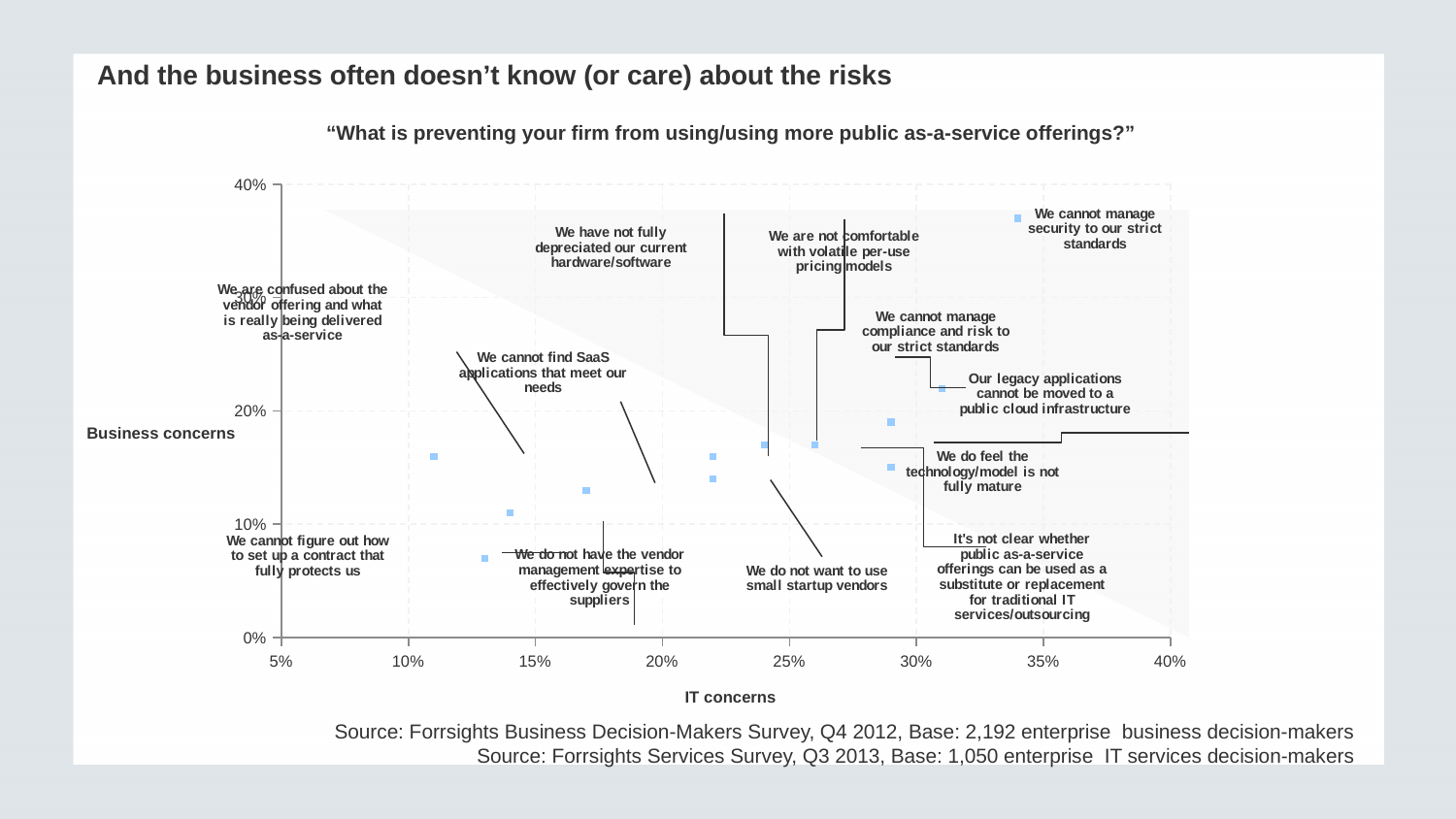
Is the Business concerns value for "We cannot manage security to our strict standards" greater or less than 30%? greater Which has the higher Business concerns value: "We cannot manage security to our strict standards" or "Our legacy applications cannot be moved to a public cloud infrastructure"? We cannot manage security to our strict standards What is the title of the horizontal axis of the chart? IT concerns Which concern has the highest Business concerns value on the chart? We cannot manage security to our strict standards What is the title of the vertical axis of the chart? Business concerns Is the IT concerns value for "We cannot manage security to our strict standards" greater or less than 30%? greater What is the maximum value shown on the vertical axis of the chart? 40% What kind of chart is shown on the slide? Scatter chart How many data points are plotted on the chart? 12